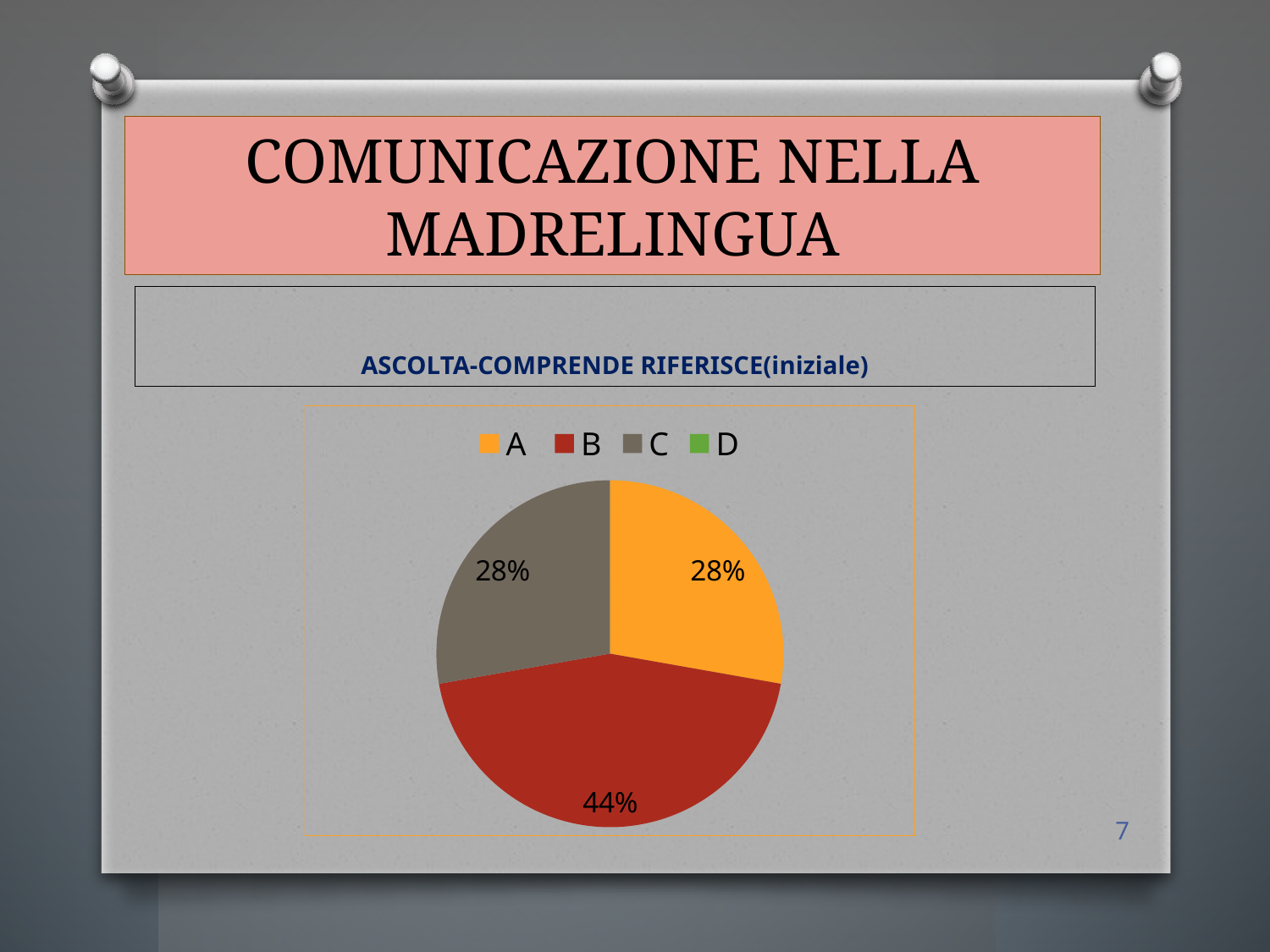
Which is larger, the slice for B or the slice for A? B How many entries does the legend of the pie chart list? 4 What kind of chart is shown on the slide? pie chart Which category has the largest slice of the pie chart? B What is the share for category A in the pie chart? 28% What is the share for category B in the pie chart? 44% What is the title of the chart? ASCOLTA-COMPRENDE RIFERISCE(iniziale) What is the share for category C in the pie chart? 28% What is the difference between the share for B and the share for C? 16% How many slices with a percentage label are shown in the pie chart? 3 What colour is the slice for category B in the pie chart? red